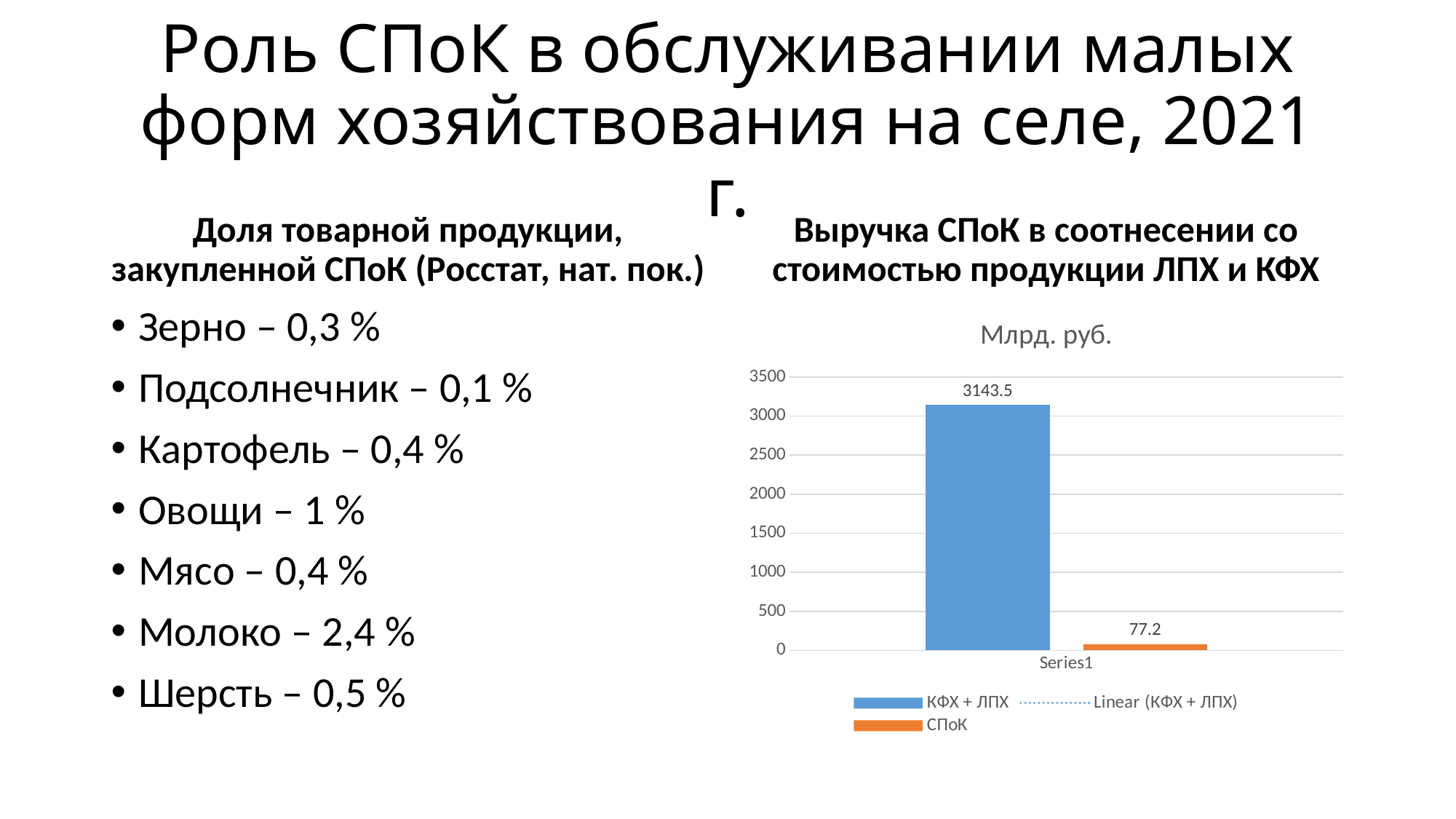
How many entries does the chart legend list? 3 What is the title shown above the chart's plot area? Млрд. руб. What is the difference between the КФХ + ЛПХ value and the СПоК value in the chart? 3066.3 Which series has the lowest value in the chart? СПоК What kind of chart is shown on the slide? bar chart Is the value for СПоК greater or less than 500? less How many bars are plotted in the chart? 2 What colour is the СПоК bar in the chart? orange What is the value of the СПоК bar in the chart? 77.2 Which series has the higher value in the chart, КФХ + ЛПХ or СПоК? КФХ + ЛПХ What is the value of the КФХ + ЛПХ bar in the chart? 3143.5 Is the value for КФХ + ЛПХ greater or less than 3000? greater